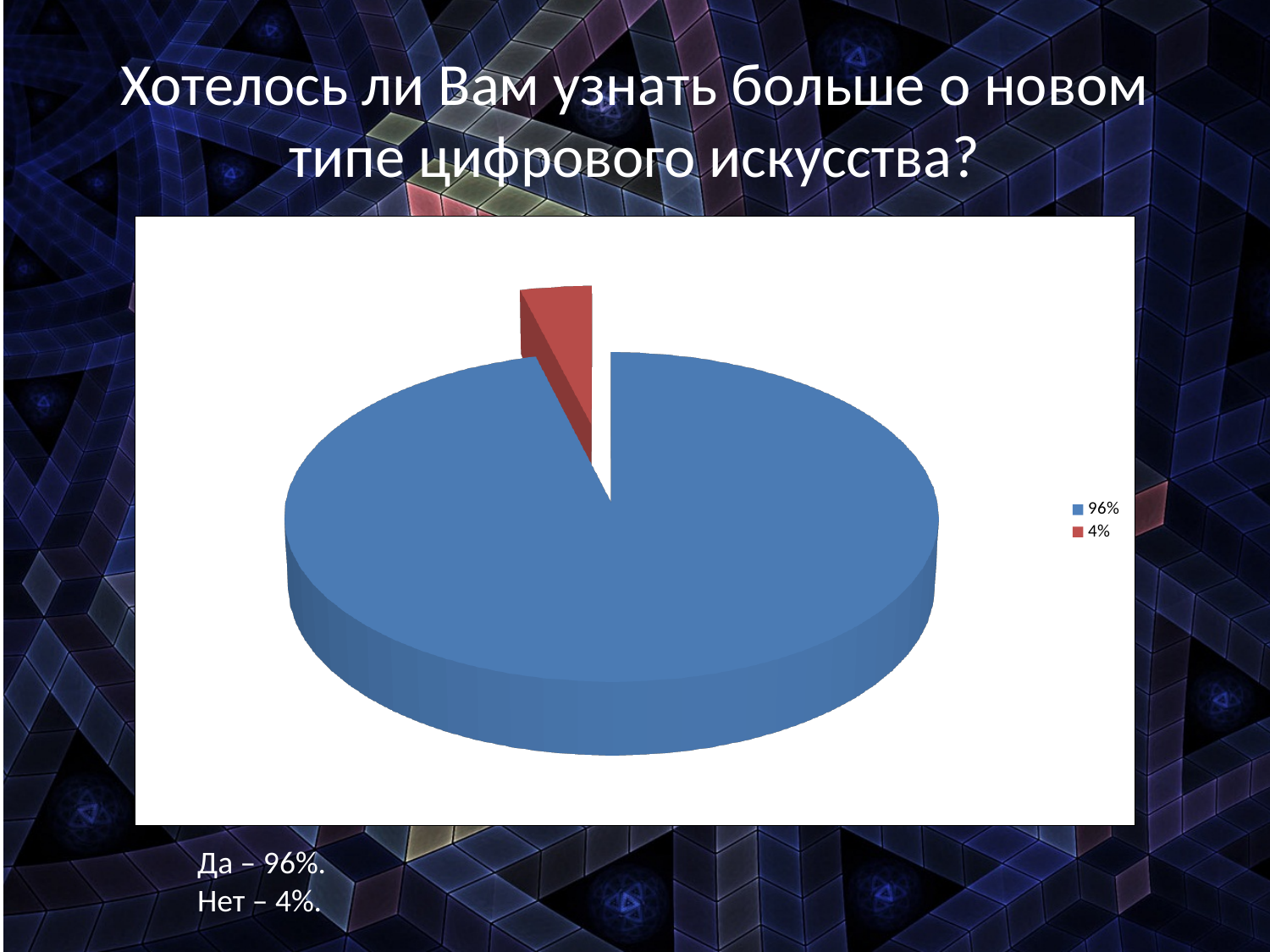
What colour is the slice representing 4%? red According to the slide, what percentage of respondents answered "Нет"? 4% What is the difference in percentage points between the "Да" share and the "Нет" share? 92 What share of the pie does the red slice represent? 4% How many slices does the pie chart have? 2 What kind of chart is shown on the slide? pie chart How many entries does the chart legend list? 2 What share of the pie does the blue slice represent? 96% Which is larger, the share for "Да" or the share for "Нет"? Да Which slice of the pie is the smallest? 4% Which slice of the pie is the largest? 96% According to the slide, what percentage of respondents answered "Да"? 96%